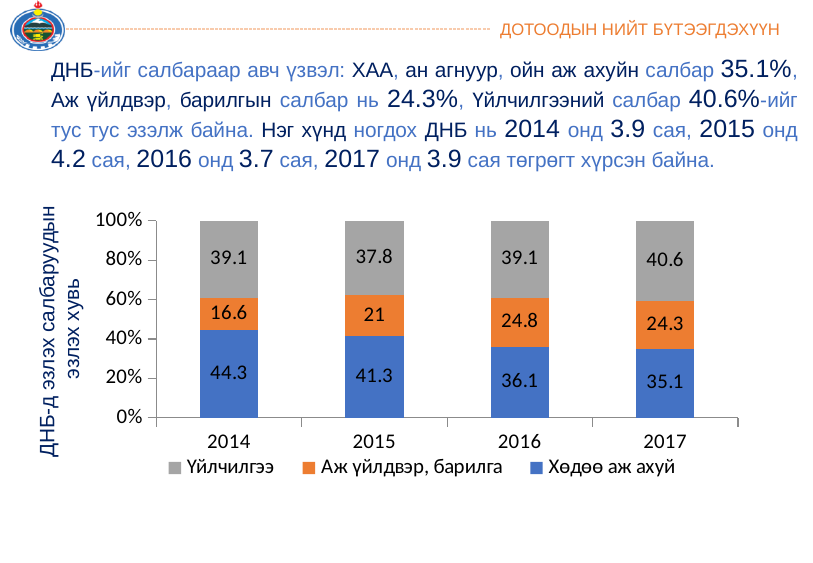
Which is larger in 2015: the Үйлчилгээ value or the Хөдөө аж ахуй value? Хөдөө аж ахуй Does the Хөдөө аж ахуй value rise or fall from 2014 to 2017? Fall What is the value for Үйлчилгээ in 2017? 40.6 How many years are shown on the x axis? 4 Which colour represents Аж үйлдвэр, барилга in the chart? Orange What is the difference between the Хөдөө аж ахуй values in 2014 and 2017? 9.2 How many series does the legend list? 3 In which year is the Хөдөө аж ахуй value the highest? 2014 What is the value for Хөдөө аж ахуй in 2014? 44.3 What is the value for Аж үйлдвэр, барилга in 2016? 24.8 In which year is the Аж үйлдвэр, барилга value the lowest? 2014 What kind of chart is shown on the slide? Stacked bar chart